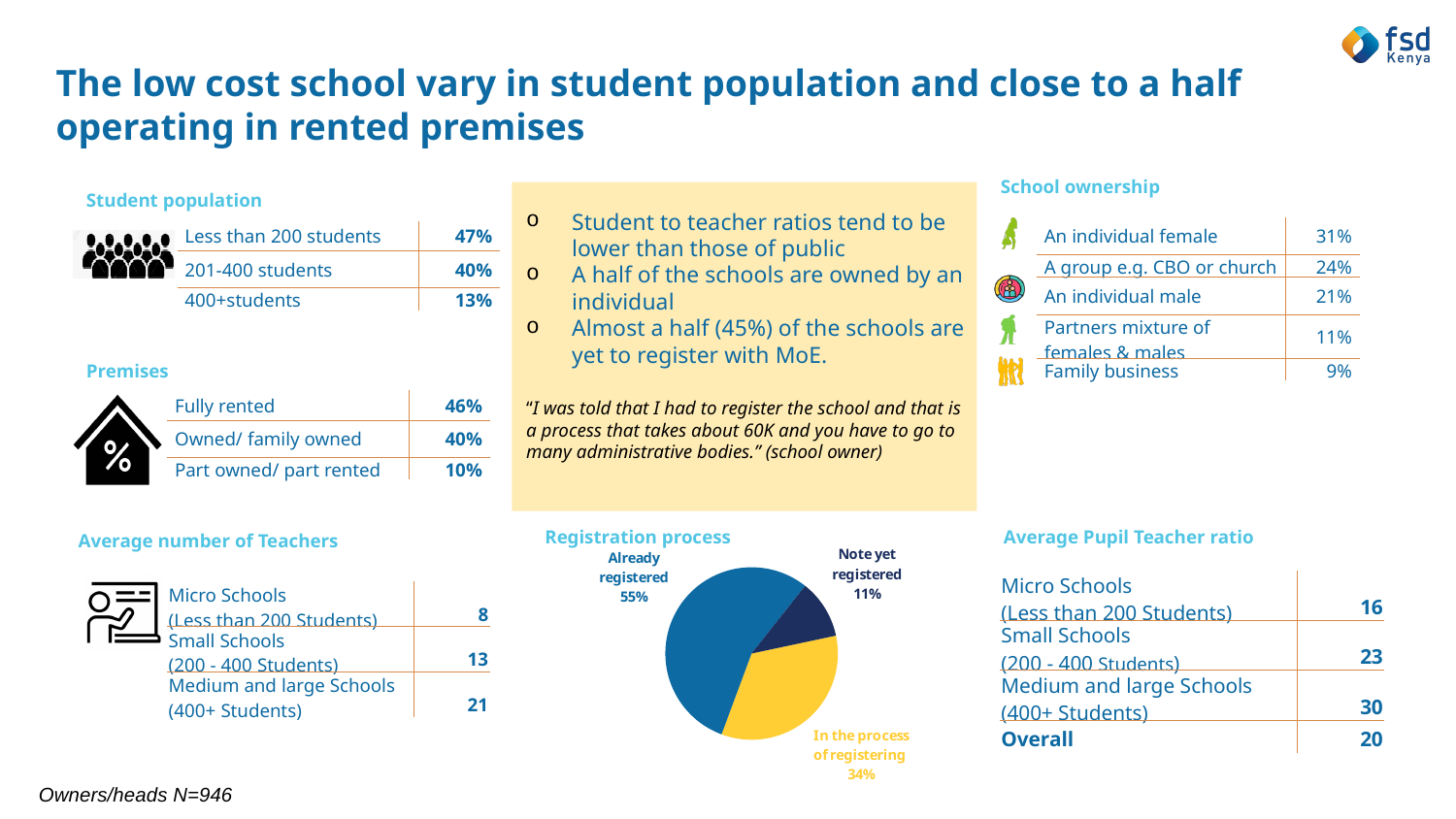
How many slices does the Registration process pie chart have? 3 In the Registration process pie chart, what share of schools are already registered? 55% In the Registration process pie chart, what share of schools are not yet registered? 11% What kind of chart is the Registration process chart? pie chart Which slice of the Registration process pie chart is the largest? Already registered Which slice of the Registration process pie chart is the smallest? Note yet registered In the Registration process pie chart, what share of schools are in the process of registering? 34% In the Registration process pie chart, what is the difference between the share in the process of registering and the share not yet registered? 23% In the Registration process pie chart, what colour is the 'In the process of registering' slice? yellow In the Registration process pie chart, which is larger: the share in the process of registering or the share not yet registered? In the process of registering In the Registration process pie chart, what is the difference between the share already registered and the share in the process of registering? 21% What is the title of the pie chart on the slide? Registration process